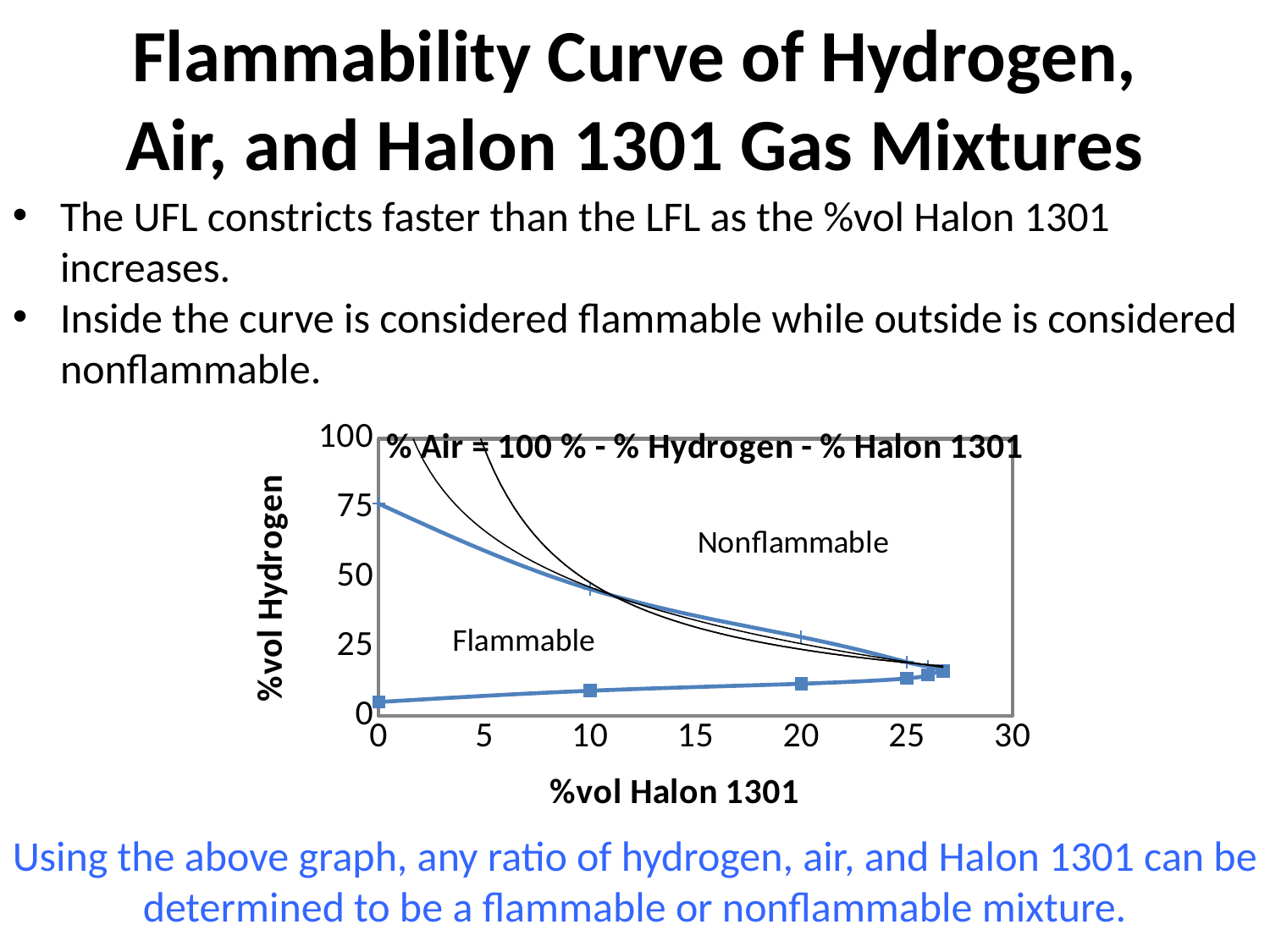
What is the label of the x axis? %vol Halon 1301 What is the highest value shown on the x axis? 30 At 0 %vol Halon 1301, which curve has the higher %vol Hydrogen, the upper (UFL) curve or the lower (LFL) curve? the upper (UFL) curve Is the %vol Hydrogen of the lower (LFL) curve at 0 %vol Halon 1301 greater or less than 25? less How many square markers are plotted on the lower (LFL) curve? 6 What is the title of the chart? % Air = 100 % - % Hydrogen - % Halon 1301 Is the %vol Hydrogen of the upper (UFL) curve at 0 %vol Halon 1301 greater or less than 50? greater Does the upper (UFL) curve rise or fall as %vol Halon 1301 increases? fall What kind of chart is shown on the slide? line chart Does the lower (LFL) curve rise or fall as %vol Halon 1301 increases? rise Is the %vol Hydrogen of the upper (UFL) curve at 20 %vol Halon 1301 greater or less than 25? greater